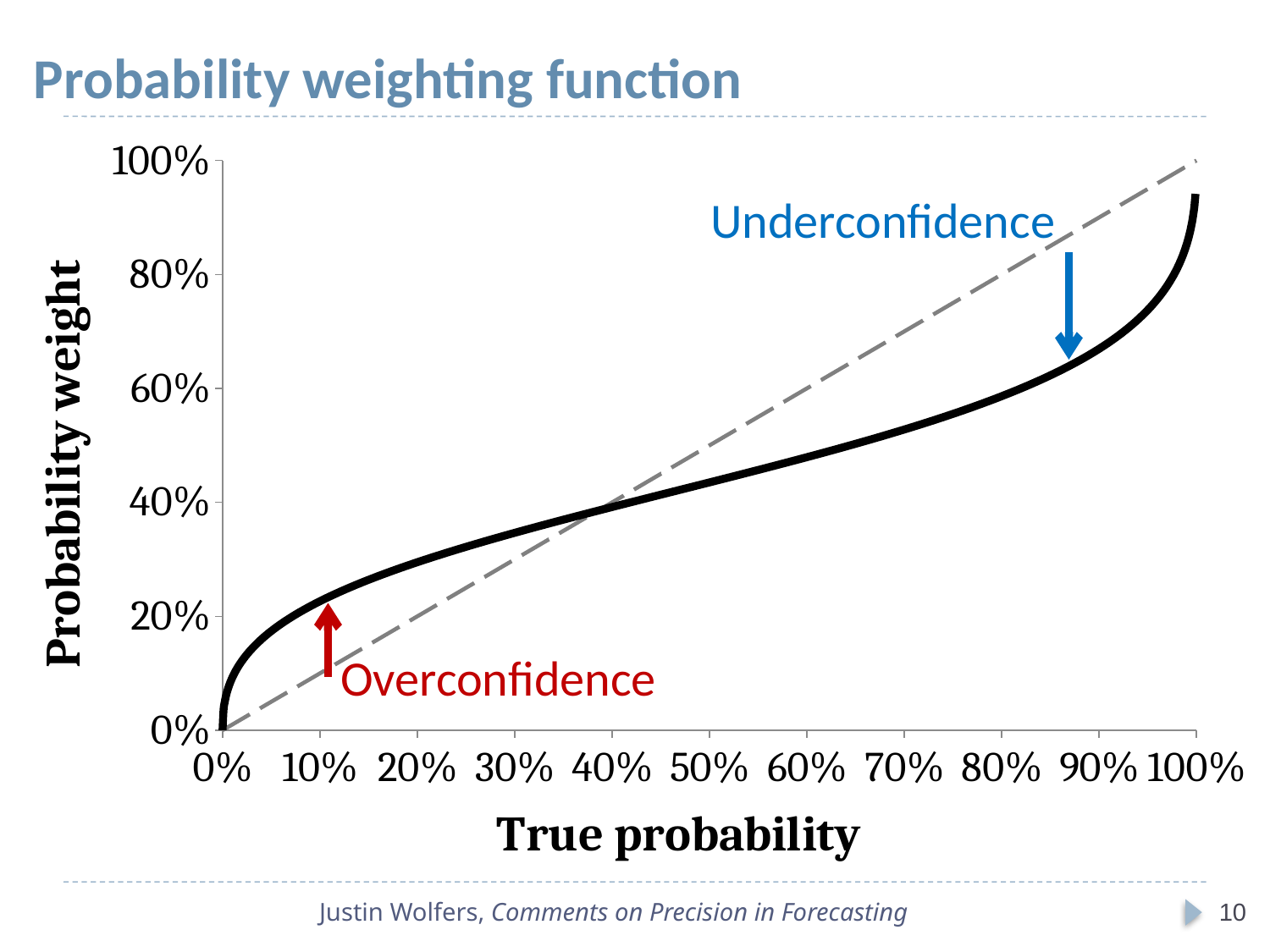
At a true probability of 10%, which is higher: the solid curve or the dashed line? The solid curve At a true probability of 50%, is the probability weight on the solid curve greater or less than 50%? less Does the solid black curve rise or fall as true probability increases from 0% to 100%? Rises How many lines are plotted on the chart? 2 At a true probability of 20%, is the probability weight on the solid curve greater or less than 20%? greater What is the label on the x axis? True probability At a true probability of 90%, is the probability weight on the solid curve greater or less than 80%? less At a true probability of 90%, which is higher: the solid curve or the dashed line? The dashed line What is the title of the chart? Probability weighting function What kind of chart is shown on the slide? Line chart What is the probability weight of the dashed line at a true probability of 100%? 100%